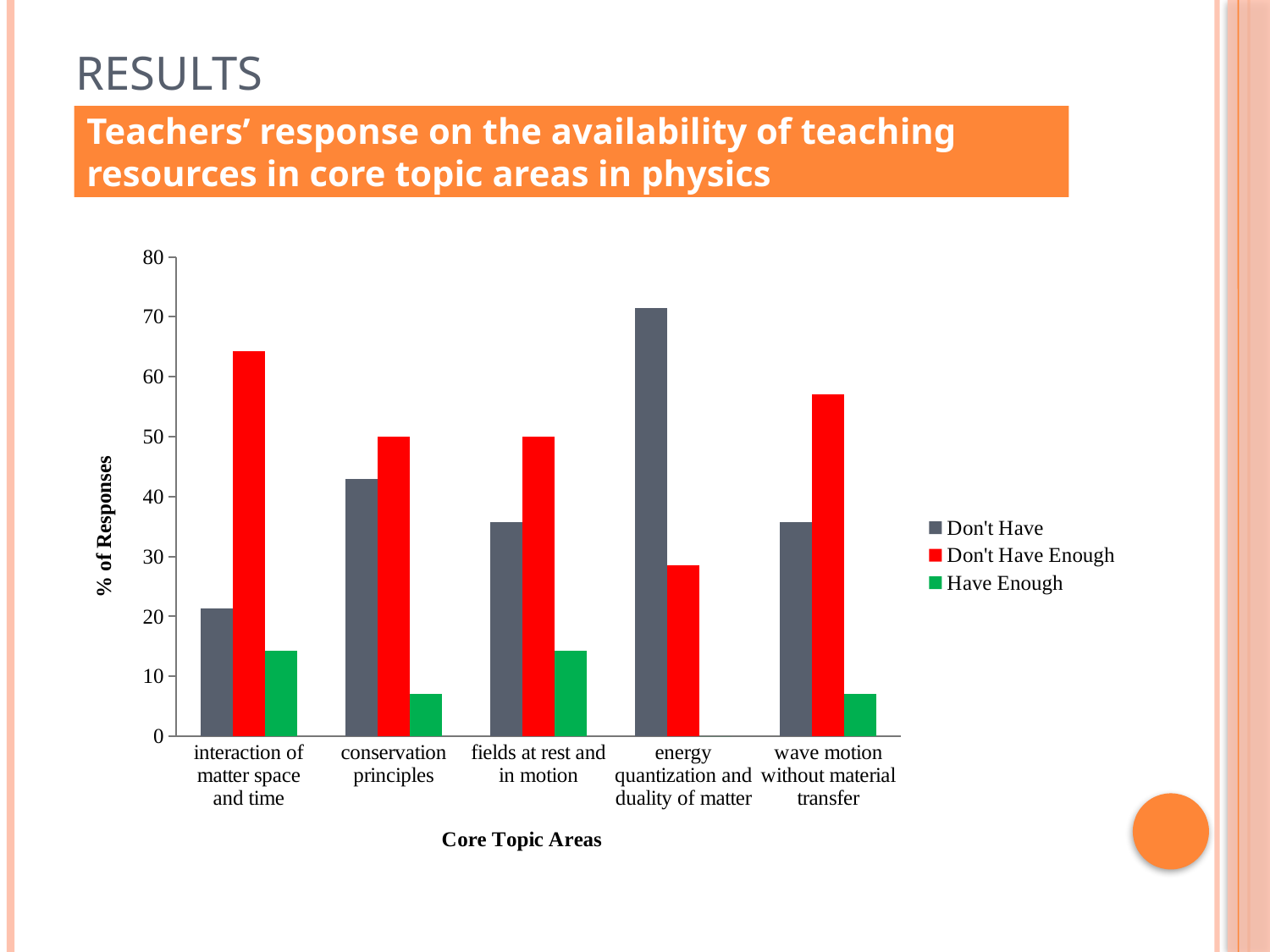
Is the 'Have Enough' value for conservation principles greater or less than 10? less How many core topic areas are shown on the x axis? 5 What kind of chart is shown on the slide? bar chart Is the 'Don't Have' value for energy quantization and duality of matter greater or less than 70? greater What is the label of the y axis? % of Responses For energy quantization and duality of matter, which is larger: 'Don't Have' or 'Don't Have Enough'? Don't Have Which core topic area has the highest 'Don't Have' response? energy quantization and duality of matter How many series does the legend list? 3 Which core topic area has the highest 'Don't Have Enough' response? interaction of matter space and time For wave motion without material transfer, which is larger: 'Don't Have' or 'Don't Have Enough'? Don't Have Enough Is the 'Don't Have Enough' value for interaction of matter space and time greater or less than 60? greater Which core topic area has the lowest 'Don't Have' response? interaction of matter space and time